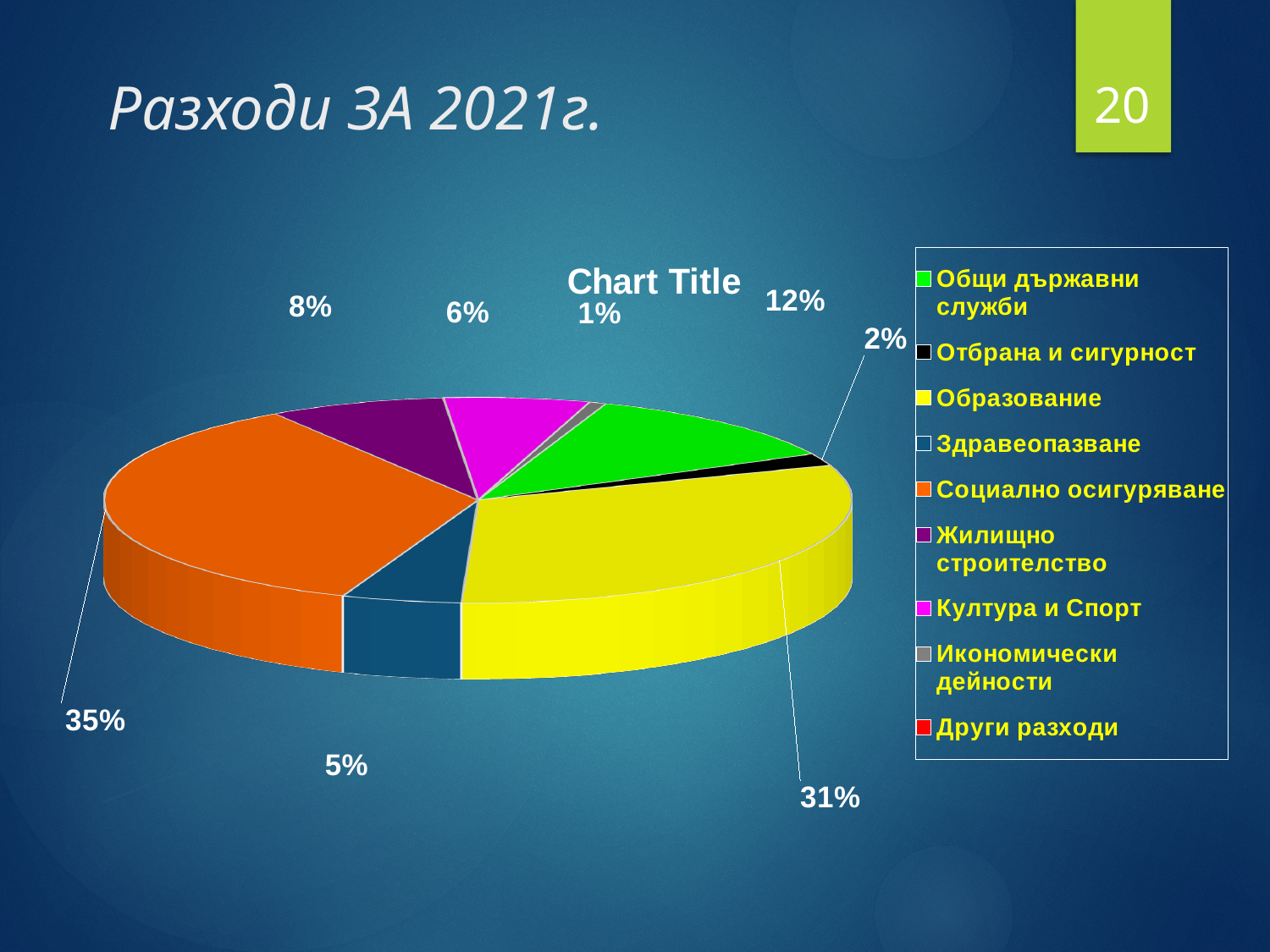
What kind of chart is shown on the slide? pie chart What share of expenses does Образование have? 31% Which labelled category has the smallest slice of the pie? Икономически дейности What share of expenses does Жилищно строителство have? 8% What share of expenses does Отбрана и сигурност have? 2% What share of expenses does Общи държавни служби have? 12% Which is larger, the share for Жилищно строителство or the share for Култура и Спорт? Жилищно строителство How many categories does the legend list? 9 Which category has the largest slice of the pie? Социално осигуряване What share of expenses does Социално осигуряване have? 35% What share of expenses does Култура и Спорт have? 6% What is the difference in percentage points between Социално осигуряване and Образование? 4 percentage points